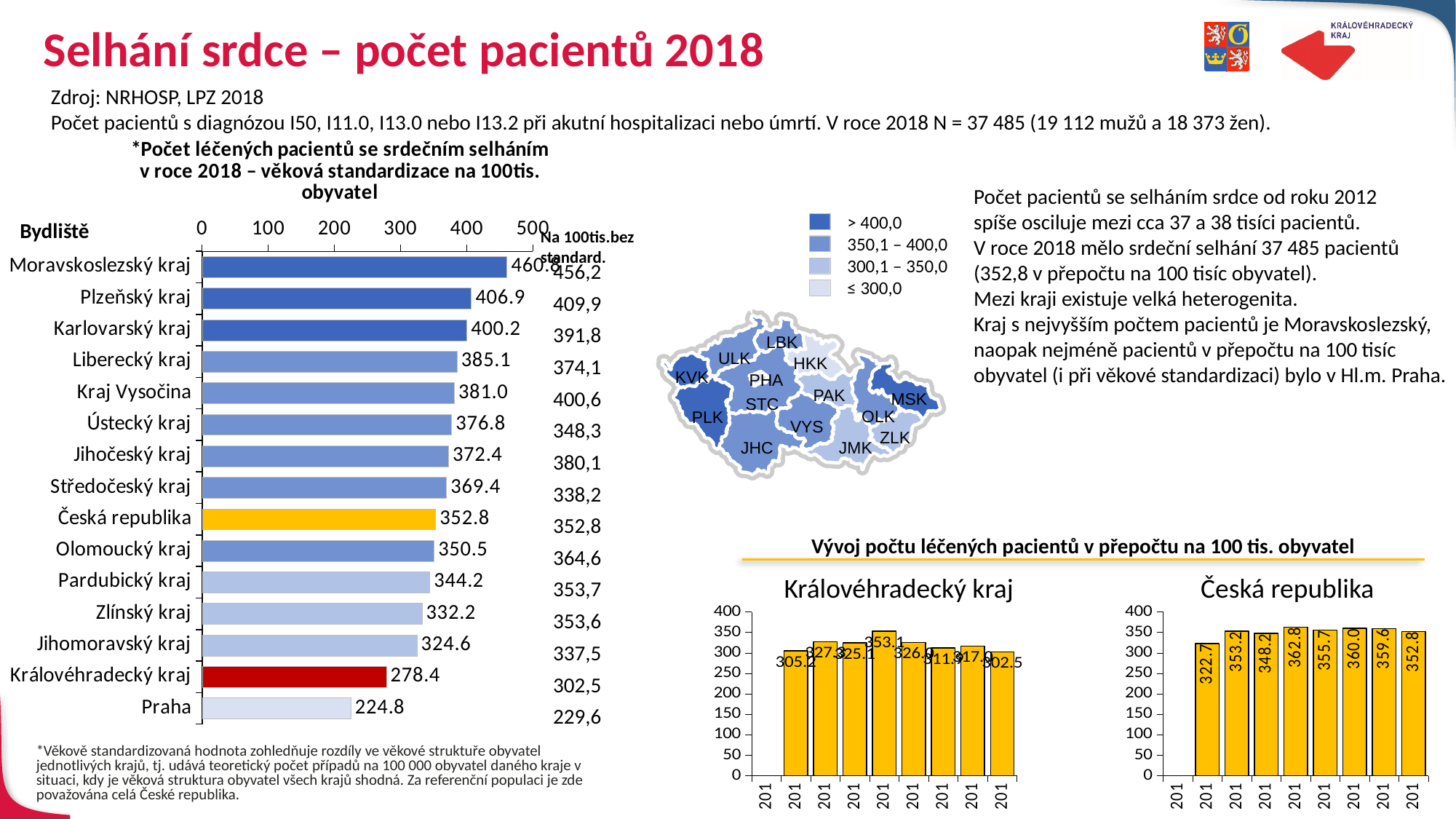
In the 'Česká republika' chart at the bottom right, how many bars are plotted? 8 In the chart '*Počet léčených pacientů se srdečním selháním v roce 2018 – věková standardizace na 100tis. obyvatel', which category has the highest value? Moravskoslezský kraj In the chart '*Počet léčených pacientů se srdečním selháním v roce 2018 – věková standardizace na 100tis. obyvatel', which is larger: the value for Liberecký kraj or Kraj Vysočina? Liberecký kraj In the chart '*Počet léčených pacientů se srdečním selháním v roce 2018 – věková standardizace na 100tis. obyvatel', what is the difference between the values for Česká republika and Královéhradecký kraj? 74.4 In the chart '*Počet léčených pacientů se srdečním selháním v roce 2018 – věková standardizace na 100tis. obyvatel', how many bars are plotted? 15 In the chart '*Počet léčených pacientů se srdečním selháním v roce 2018 – věková standardizace na 100tis. obyvatel', what is the value for Plzeňský kraj? 406.9 In the chart '*Počet léčených pacientů se srdečním selháním v roce 2018 – věková standardizace na 100tis. obyvatel', which category has the lowest value? Praha In the 'Česká republika' chart at the bottom right, what is the lowest value shown? 322.7 What kind of chart is the 'Královéhradecký kraj' chart at the bottom right of the slide? Bar chart In the chart '*Počet léčených pacientů se srdečním selháním v roce 2018 – věková standardizace na 100tis. obyvatel', what colour is the bar for Královéhradecký kraj? Red In the chart '*Počet léčených pacientů se srdečním selháním v roce 2018 – věková standardizace na 100tis. obyvatel', what is the value for Královéhradecký kraj? 278.4 In the 'Královéhradecký kraj' chart at the bottom right, what is the highest value shown? 353.1